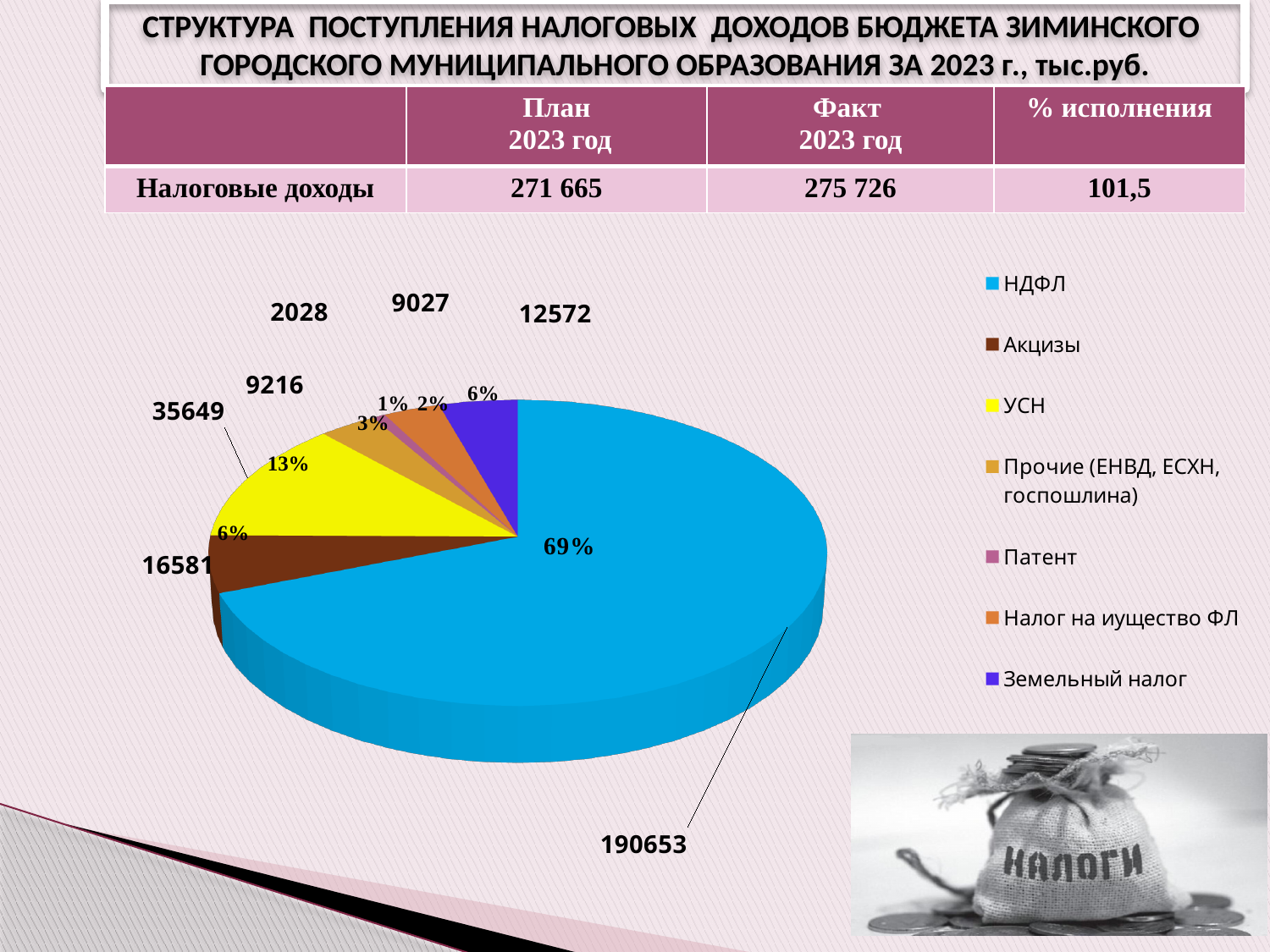
How many categories does the legend of the pie chart list? 7 What colour is the НДФЛ slice in the pie chart? blue What kind of chart is shown on the slide? pie chart What share of the pie does УСН account for? 13% What is the difference between the НДФЛ value and the УСН value? 155004 What value is labelled for the НДФЛ slice? 190653 Which category has the largest slice of the pie chart? НДФЛ What share of the pie does НДФЛ account for? 69% Which category has the smallest slice of the pie chart? Патент What value is labelled for the Акцизы slice? 16581 Which is larger, the УСН slice or the Акцизы slice? УСН What value is labelled for the УСН slice? 35649